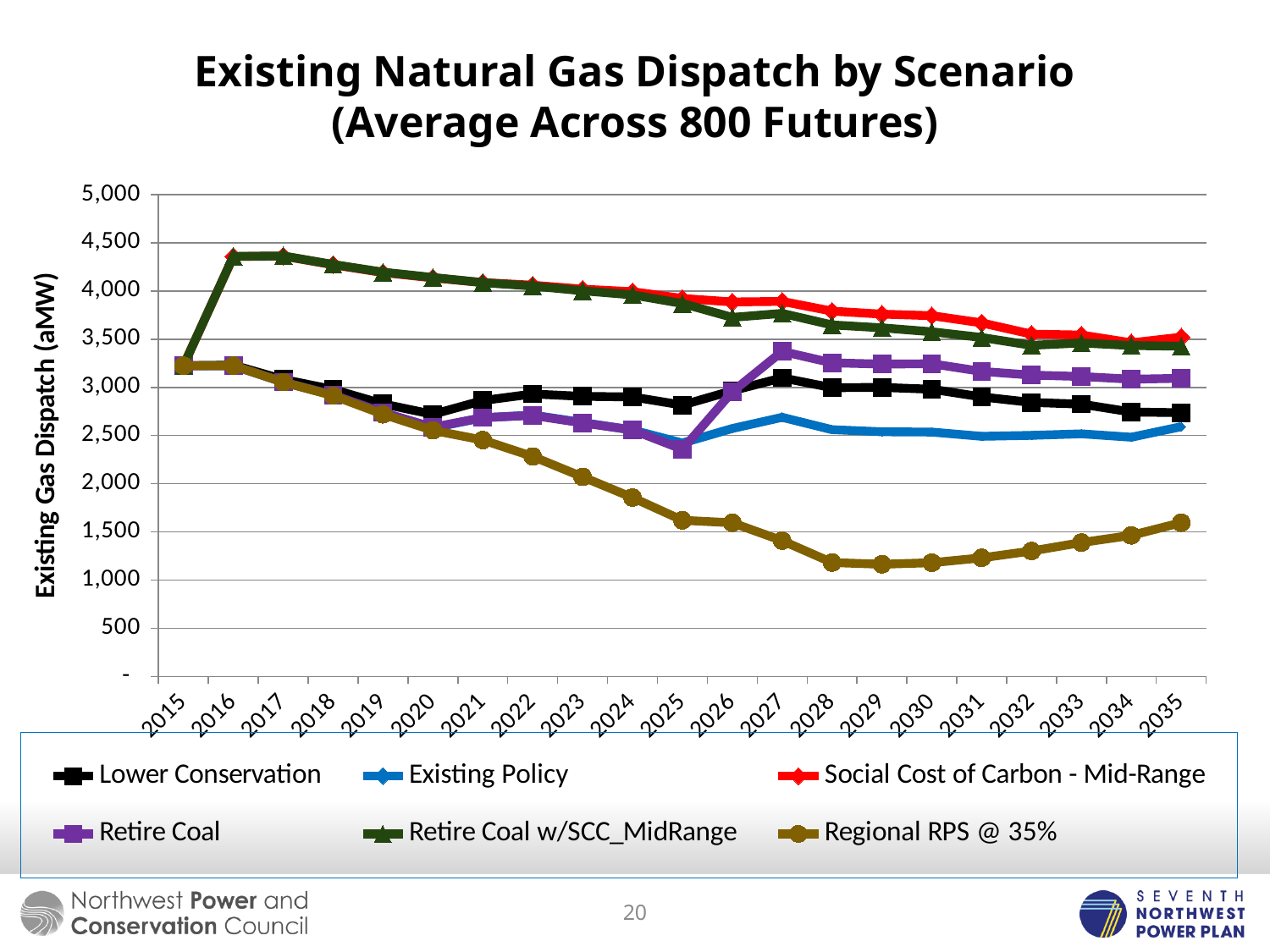
How many years are plotted along the x axis? 21 Is the value for Regional RPS @ 35% in 2029 greater or less than 1,500? less In 2030, which is larger: Retire Coal or Lower Conservation? Retire Coal Is the value for Lower Conservation in 2035 greater or less than 3,000? less Which scenario has the highest value in 2035? Social Cost of Carbon - Mid-Range Is the value for Social Cost of Carbon - Mid-Range in 2016 greater or less than 4,000? greater Does the Regional RPS @ 35% line rise or fall from 2015 to 2029? fall In 2025, which is larger: Existing Policy or Regional RPS @ 35%? Existing Policy Which scenario has the lowest value in 2029? Regional RPS @ 35% How many series does the legend list? 6 What is the label on the y axis? Existing Gas Dispatch (aMW) What kind of chart is shown on the slide? Line chart